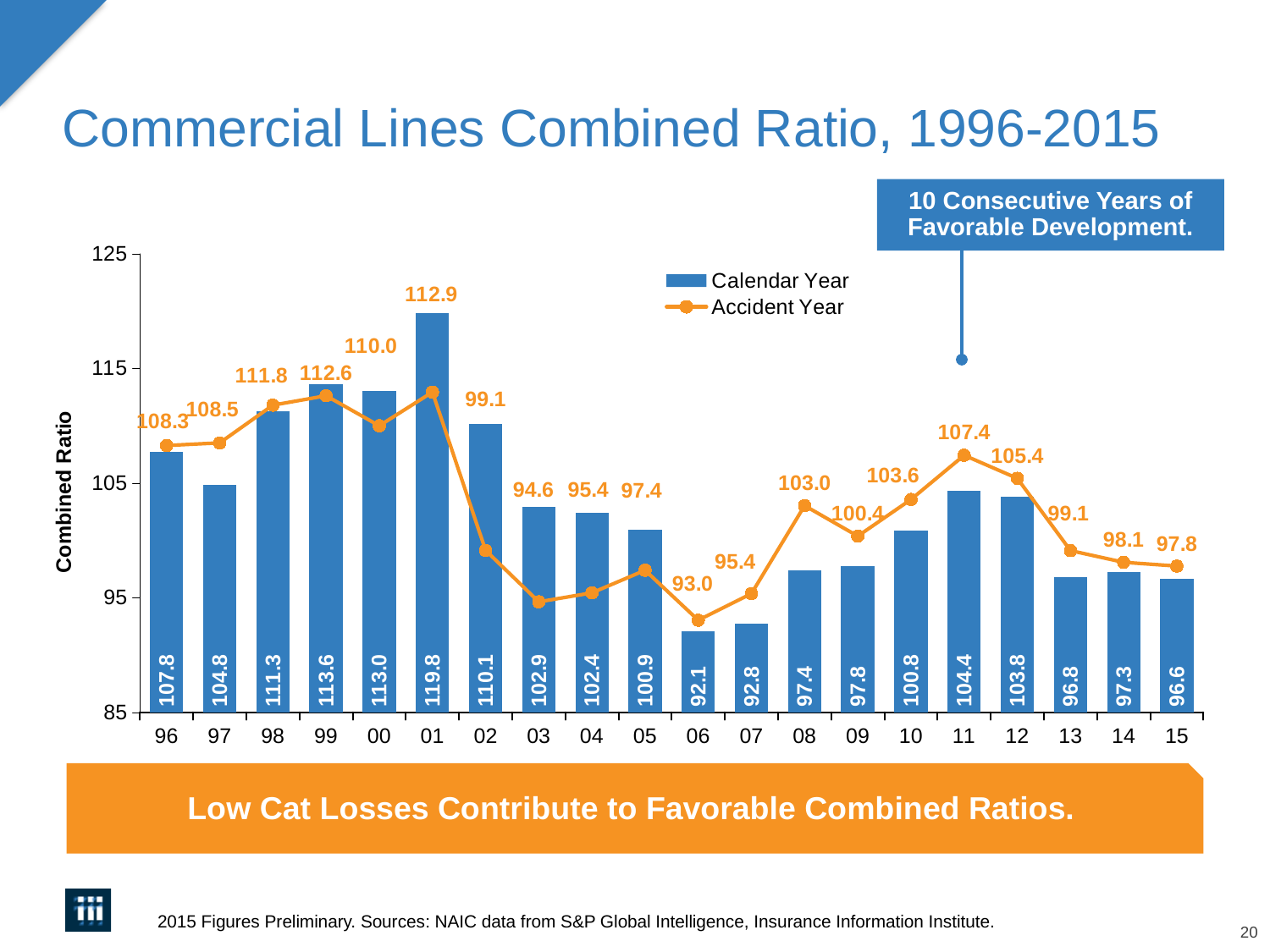
Which year has the lowest Calendar Year combined ratio? 06 What kind of chart is this? Combined bar and line chart What is the Accident Year combined ratio for 2011? 107.4 Does the Calendar Year combined ratio rise or fall from 2012 to 2015? Fall What is the difference between the Calendar Year combined ratio in 2001 and in 2006? 27.7 What is the Calendar Year combined ratio for 2015? 96.6 How many series does the legend list? 2 What is the Calendar Year combined ratio for 2001? 119.8 How many years are shown on the x axis? 20 Which year has the lowest Accident Year combined ratio? 06 Which is larger in 2008, the Calendar Year combined ratio or the Accident Year combined ratio? Accident Year Which year has the highest Calendar Year combined ratio? 01